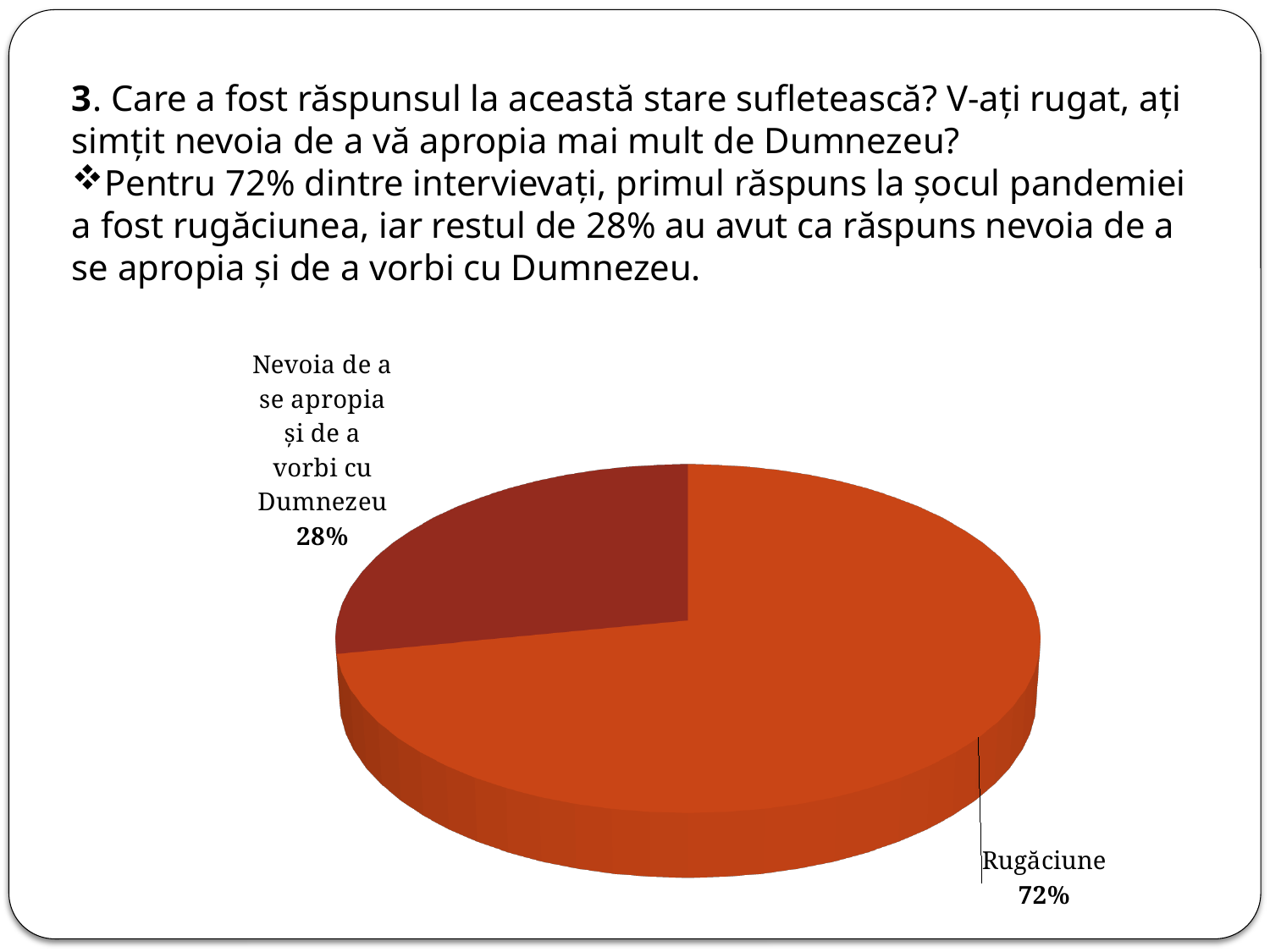
Which is larger: the "Rugăciune" slice or the "Nevoia de a se apropia și de a vorbi cu Dumnezeu" slice? Rugăciune What share of the pie does the "Nevoia de a se apropia și de a vorbi cu Dumnezeu" slice represent? 28% What kind of chart is shown on the slide? Pie chart Which slice of the pie is drawn in the darker red colour? Nevoia de a se apropia și de a vorbi cu Dumnezeu What share of the pie does the "Rugăciune" slice represent? 72% Which slice of the pie is the largest? Rugăciune What is the total of the two slices shown in the pie chart? 100% How many slices does the pie chart have? 2 Is the share for "Rugăciune" greater or less than 50%? greater What is the difference in percentage points between the "Rugăciune" slice and the "Nevoia de a se apropia și de a vorbi cu Dumnezeu" slice? 44 percentage points Which slice of the pie is the smallest? Nevoia de a se apropia și de a vorbi cu Dumnezeu